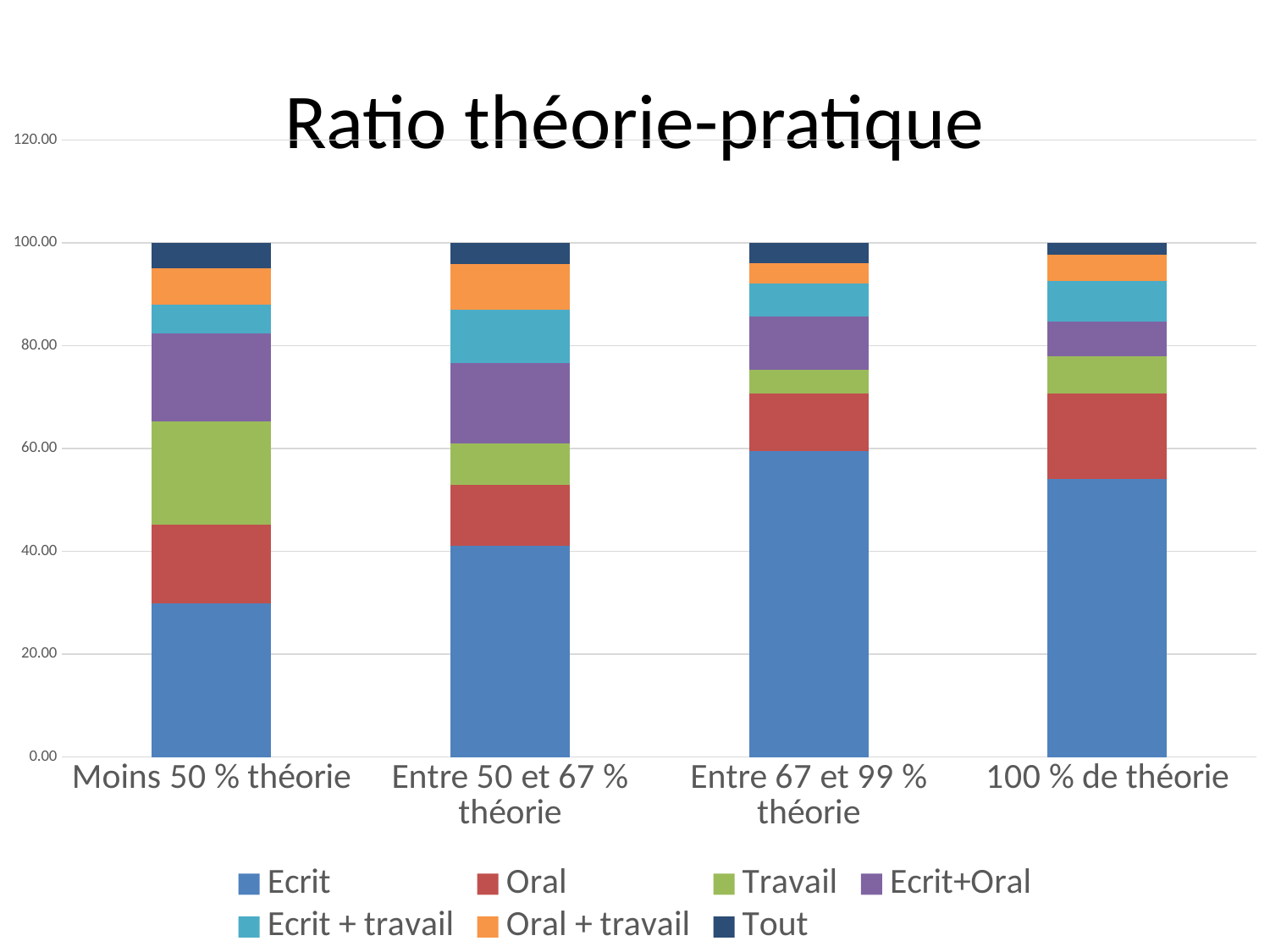
Is the Ecrit value for Entre 67 et 99 % théorie greater or less than 40.00? greater Is the Ecrit value for Moins 50 % théorie greater or less than 40.00? less Which category has the largest Ecrit segment? Entre 67 et 99 % théorie What is the total height of the stacked bar for 100 % de théorie? 100.00 Which has a larger Ecrit segment: Moins 50 % théorie or 100 % de théorie? 100 % de théorie Which has a larger Travail segment: Moins 50 % théorie or Entre 67 et 99 % théorie? Moins 50 % théorie How many series does the legend list? 7 What kind of chart is shown on the slide? Stacked bar chart Which category has the largest Travail segment? Moins 50 % théorie Which category has the smallest Ecrit segment? Moins 50 % théorie How many categories are shown on the x axis? 4 What is the title of the chart? Ratio théorie-pratique